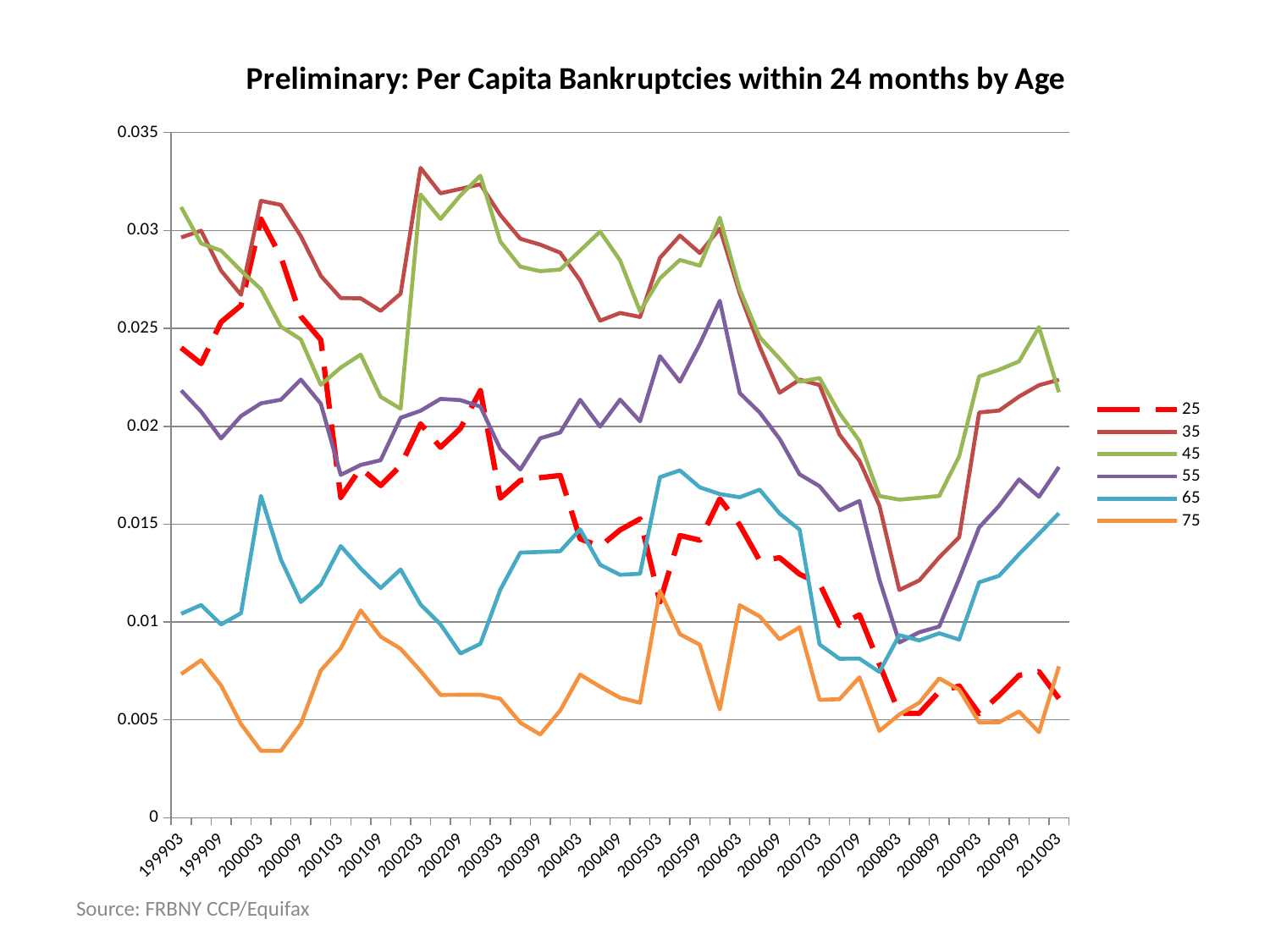
Is the value for the 35 series at 200803 greater or less than 0.01? greater Is the value for the 45 series at 200203 greater or less than 0.03? greater Is the value for the 55 series at 200603 greater or less than 0.025? less Which series has the lowest value at 200003? 75 Which series has the highest value at 200903? 45 What is the title of the chart? Preliminary: Per Capita Bankruptcies within 24 months by Age What kind of chart is shown on the slide? line chart How many labels are shown on the x axis? 23 How many series does the legend list? 6 At 201003, which series has the larger value, 45 or 65? 45 Which series in the legend is drawn as a dashed line? 25